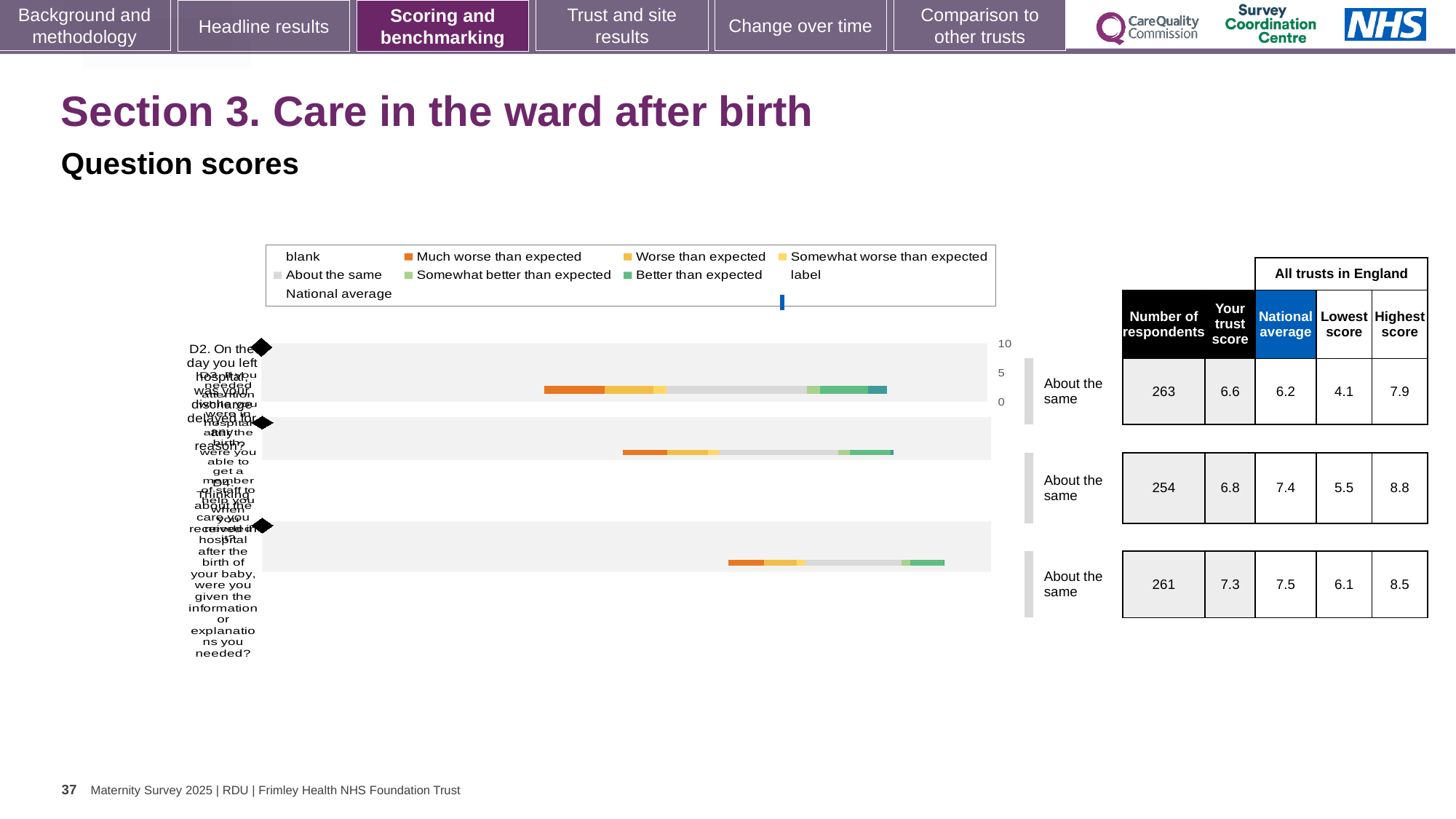
In the table beside the chart, what is the national average for the second row? 7.4 What kind of chart is shown on the slide? bar chart What benchmark label is shown next to each of the three bars? About the same Which colour does the legend use for "Much worse than expected"? orange In the table beside the chart, what is the number of respondents for the first row (D2, discharge delayed)? 263 How many horizontal bars are plotted in the chart? 3 In the table beside the chart, what is the difference between the highest score and lowest score in the second row? 3.3 In the table beside the chart, which row has the highest trust score: the first, second or third? third In the table beside the chart, is the trust score for the first row larger or smaller than its national average? larger In the table beside the chart, what is the trust score for the first row (D2, discharge delayed)? 6.6 What is the subtitle above the chart? Question scores In the table beside the chart, what is the highest score for the third row? 8.5